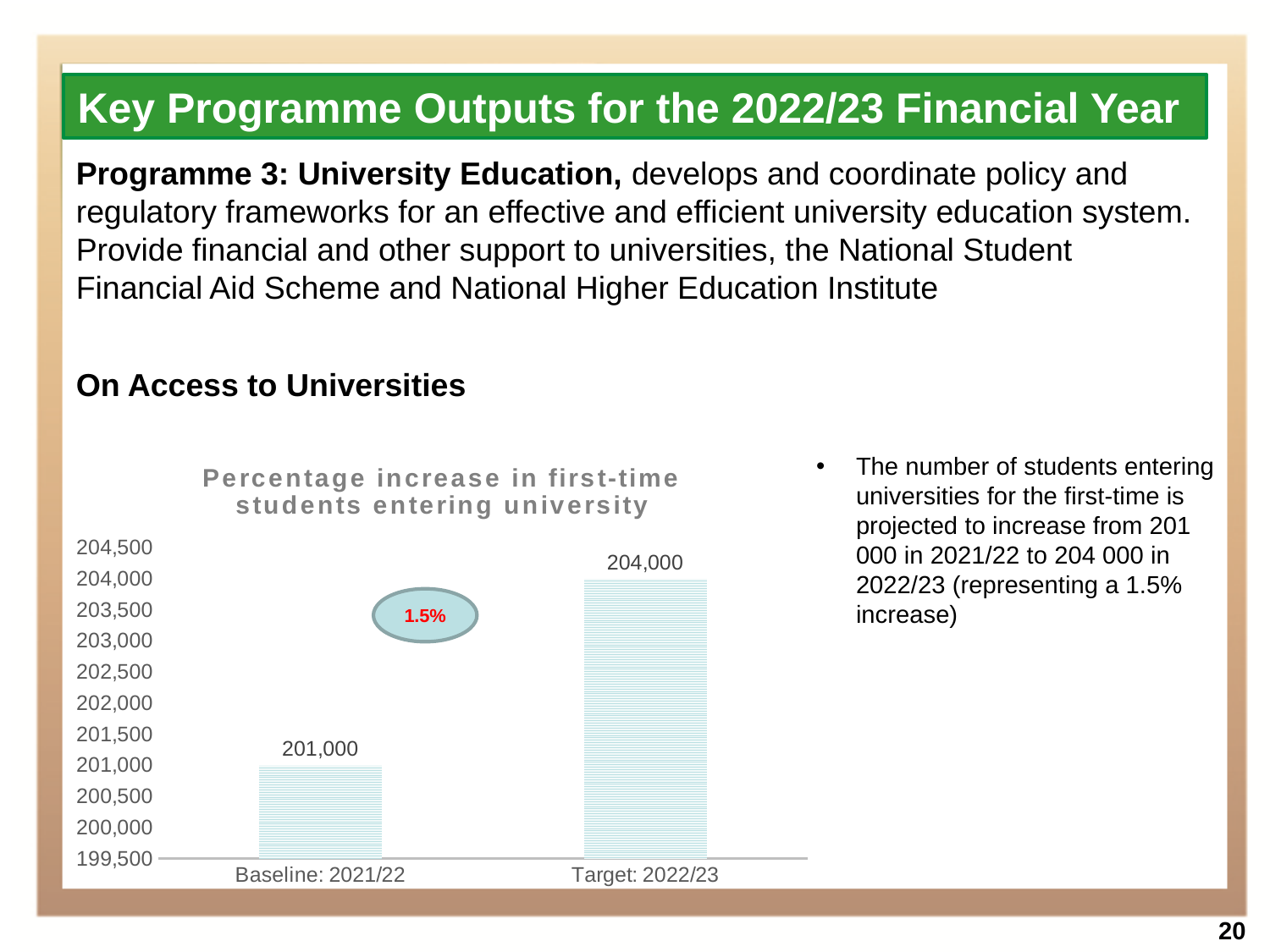
What is the value for Baseline: 2021/22? 201,000 Which category has the lowest value? Baseline: 2021/22 Which category has the highest value? Target: 2022/23 What kind of chart is shown on the slide? bar chart Which is larger, the value for Baseline: 2021/22 or the value for Target: 2022/23? Target: 2022/23 Is the value for Baseline: 2021/22 greater or less than 202,000? less Is the value for Target: 2022/23 greater or less than 203,000? greater What is the title of the chart? Percentage increase in first-time students entering university What is the difference between the Target: 2022/23 value and the Baseline: 2021/22 value? 3,000 What is the value for Target: 2022/23? 204,000 How many categories are shown on the x axis? 2 Do the values rise or fall from Baseline: 2021/22 to Target: 2022/23? rise